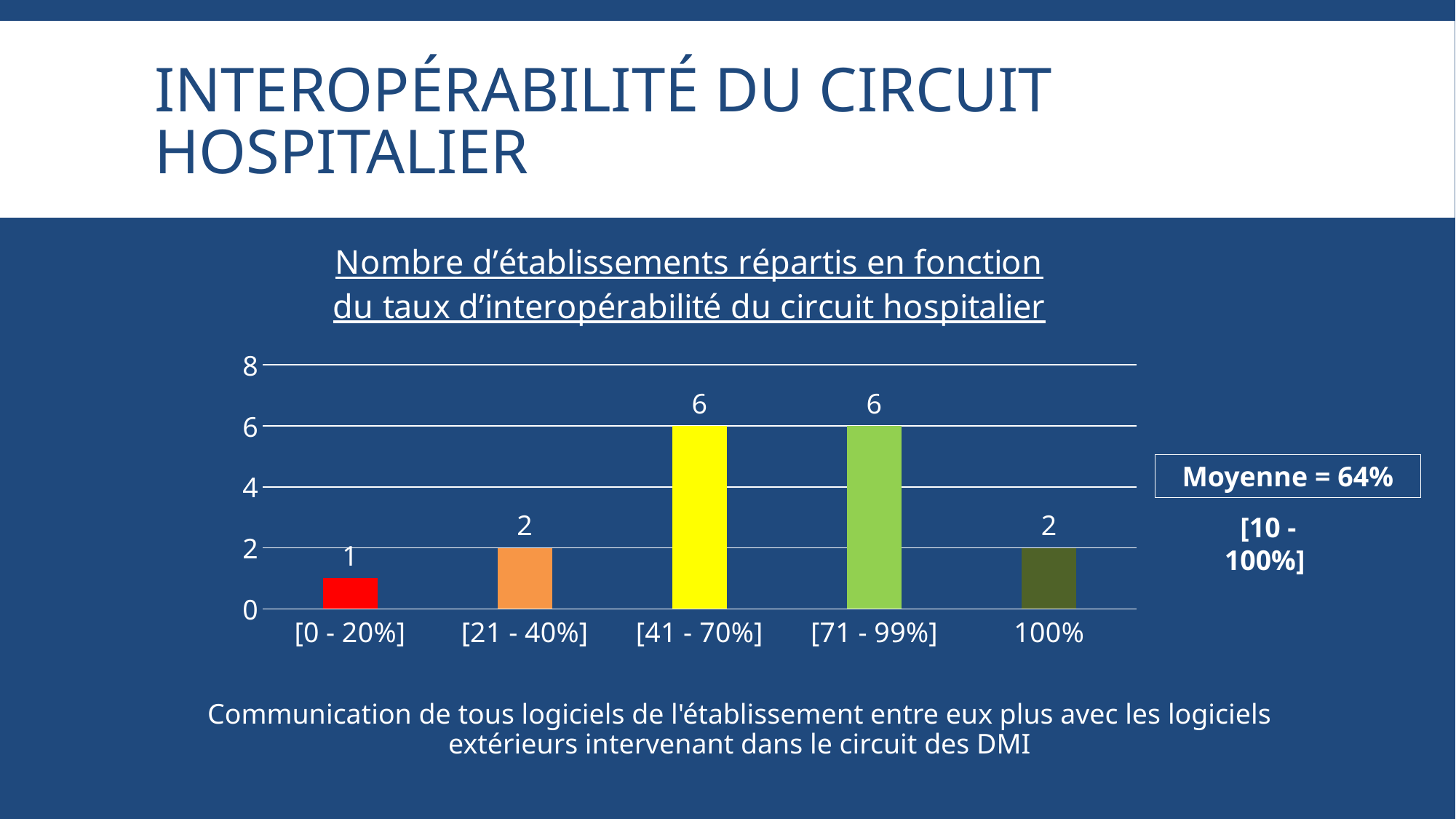
What is the total number of establishments across all five categories? 17 How many categories are shown on the x axis? 5 What kind of chart is shown on the slide? bar chart What is the difference between the values for [71 - 99%] and [21 - 40%]? 4 What is the value for the [41 - 70%] category? 6 What average (Moyenne) value is shown in the box next to the chart? 64% What is the value for the 100% category? 2 What is the value for the [21 - 40%] category? 2 Which category has the lowest value? [0 - 20%] What is the value for the [0 - 20%] category? 1 Which is larger, the value for [41 - 70%] or the value for 100%? [41 - 70%] Is the value for [71 - 99%] greater or less than 4? greater